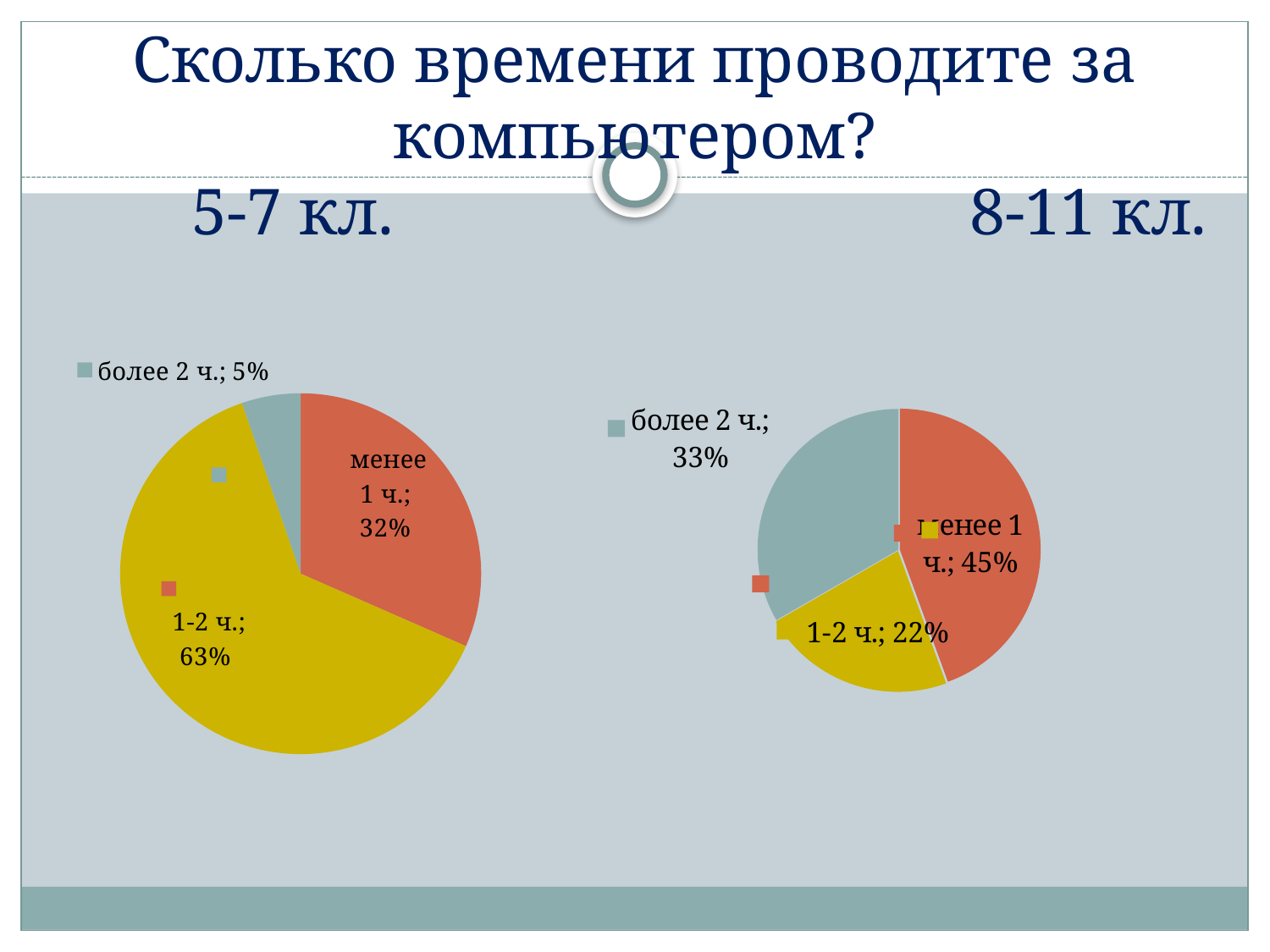
In the 5-7 кл. chart, what share is labelled for 1-2 ч.? 63% Which chart shows a larger share for более 2 ч., 5-7 кл. or 8-11 кл.? 8-11 кл. In the 8-11 кл. chart, what share is labelled for более 2 ч.? 33% In the 5-7 кл. chart, which category has the largest slice? 1-2 ч. What is the title of the slide? Сколько времени проводите за компьютером? In the 5-7 кл. chart, what share is labelled for более 2 ч.? 5% In the 8-11 кл. chart, what is the difference between the shares for менее 1 ч. and более 2 ч.? 12% What type of chart is used on the left for 5-7 кл.? Pie chart In the 5-7 кл. chart, what is the difference between the shares for 1-2 ч. and менее 1 ч.? 31% How many slices does the 8-11 кл. pie chart have? 3 In the 8-11 кл. chart, what share is labelled for менее 1 ч.? 45% In the 8-11 кл. chart, which category has the smallest slice? 1-2 ч.